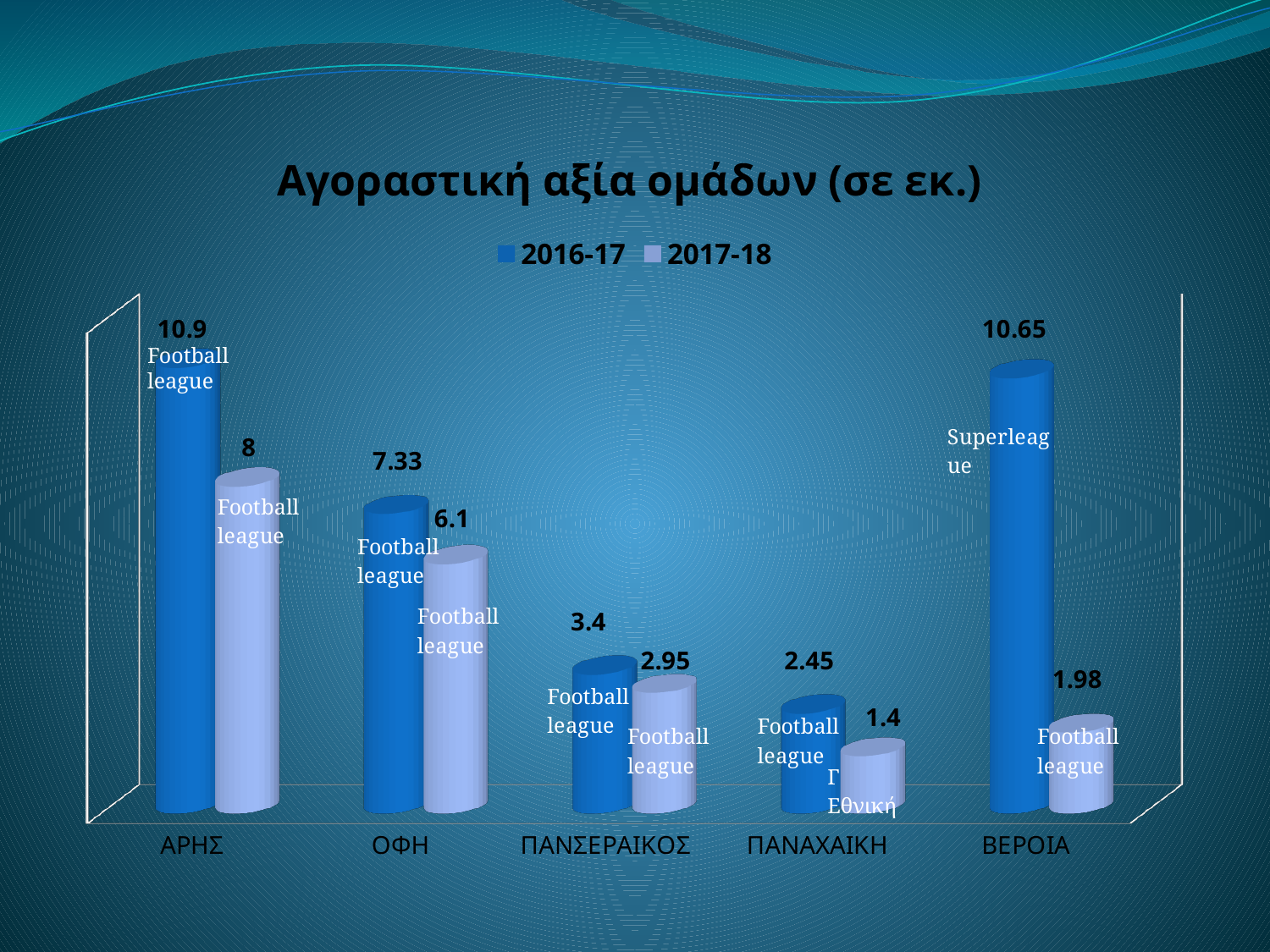
Which team has the highest value in the 2016-17 series? ΑΡΗΣ How many teams are shown on the x axis? 5 What is the value for ΠΑΝΑΧΑΙΚΗ in the 2016-17 series? 2.45 What is the value for ΟΦΗ in the 2017-18 series? 6.1 Which is larger: the 2017-18 value for ΑΡΗΣ or the 2016-17 value for ΟΦΗ? 2017-18 value for ΑΡΗΣ Which team has the lowest value in the 2017-18 series? ΠΑΝΑΧΑΙΚΗ What is the difference between the 2016-17 and 2017-18 values for ΒΕΡΟΙΑ? 8.67 What kind of chart is shown on the slide? Bar chart How many series does the legend list? 2 What is the value for ΑΡΗΣ in the 2016-17 series? 10.9 Which league label is shown on the 2016-17 bar for ΒΕΡΟΙΑ? Superleague What is the value for ΒΕΡΟΙΑ in the 2017-18 series? 1.98